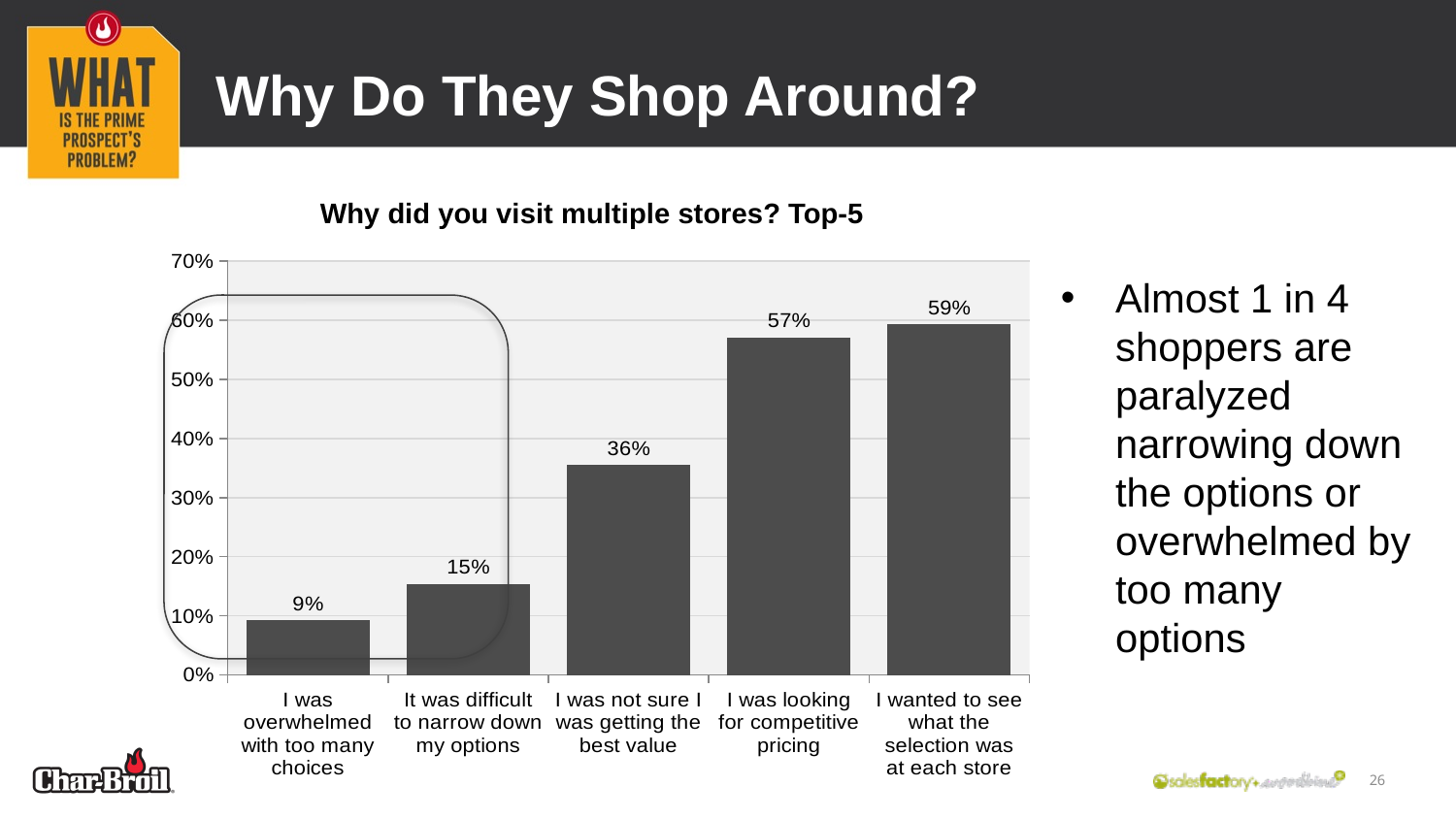
How many reasons are shown in the chart? 5 What is the difference between 'I wanted to see what the selection was at each store' and 'I was looking for competitive pricing'? 2% What is the value for 'I was looking for competitive pricing'? 57% What kind of chart is shown on the slide? Bar chart What is the difference between 'I was not sure I was getting the best value' and 'It was difficult to narrow down my options'? 21% What percentage of respondents said they were overwhelmed with too many choices? 9% Is the value for 'I was not sure I was getting the best value' greater or less than 40%? less Which is larger: 'It was difficult to narrow down my options' or 'I was overwhelmed with too many choices'? It was difficult to narrow down my options What is the value for 'I was not sure I was getting the best value'? 36% What is the title of the chart? Why did you visit multiple stores? Top-5 Which reason has the highest percentage? I wanted to see what the selection was at each store Which reason has the lowest percentage? I was overwhelmed with too many choices